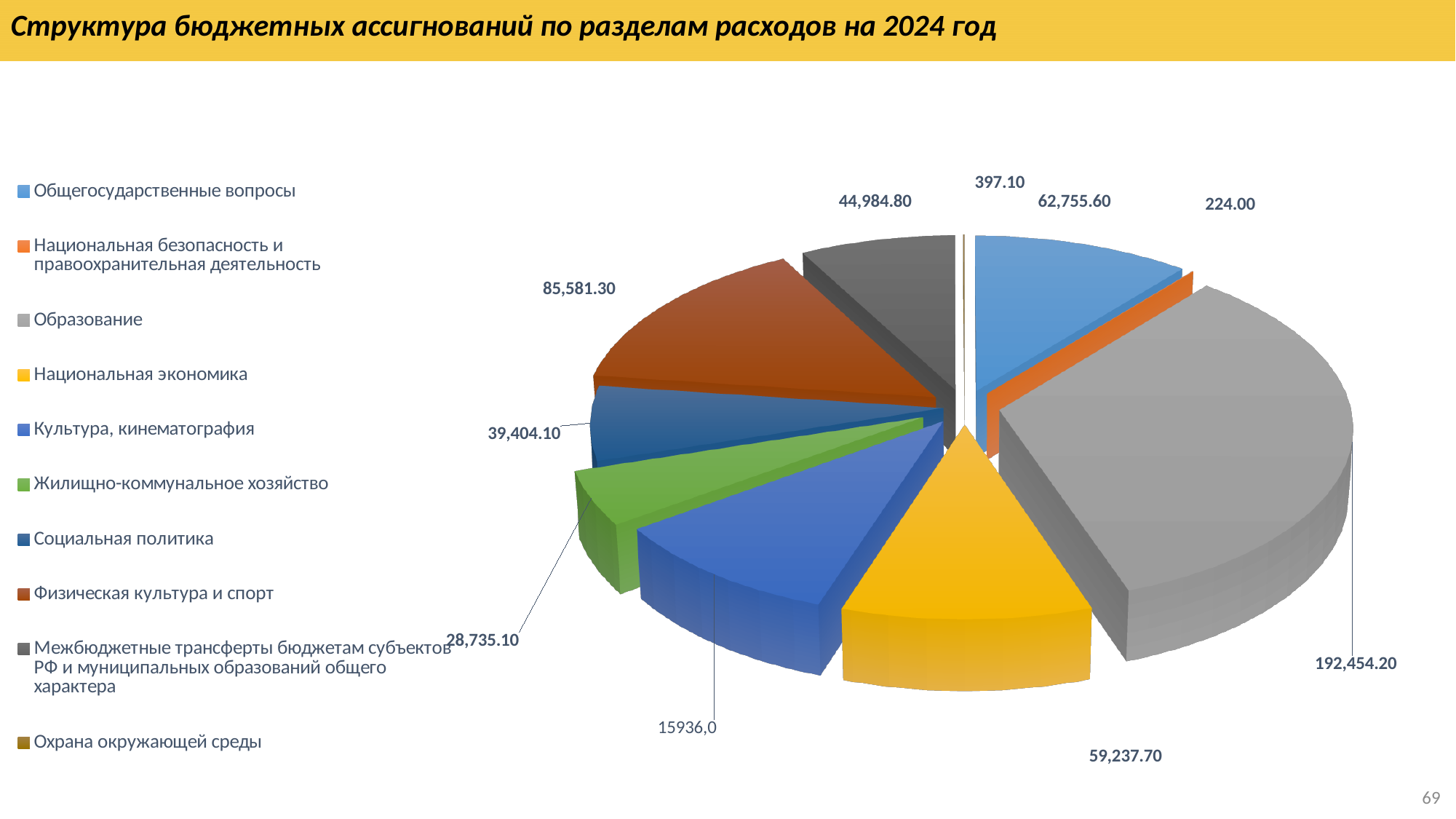
Which is larger: the value for Общегосударственные вопросы or the value for Национальная экономика? Общегосударственные вопросы What is the value for Охрана окружающей среды? 397.10 What is the value for Физическая культура и спорт? 85,581.30 What kind of chart is shown on the slide? Pie chart Which category has the smallest value? Национальная безопасность и правоохранительная деятельность What is the difference between the values for Физическая культура и спорт and Межбюджетные трансферты бюджетам субъектов РФ и муниципальных образований общего характера? 40,596.50 What is the value for Общегосударственные вопросы? 62,755.60 What colour is the slice for Национальная экономика? Yellow What is the value for Образование? 192,454.20 How many categories does the pie chart have? 10 Which category has the largest slice of the pie? Образование What is the value for Социальная политика? 39,404.10